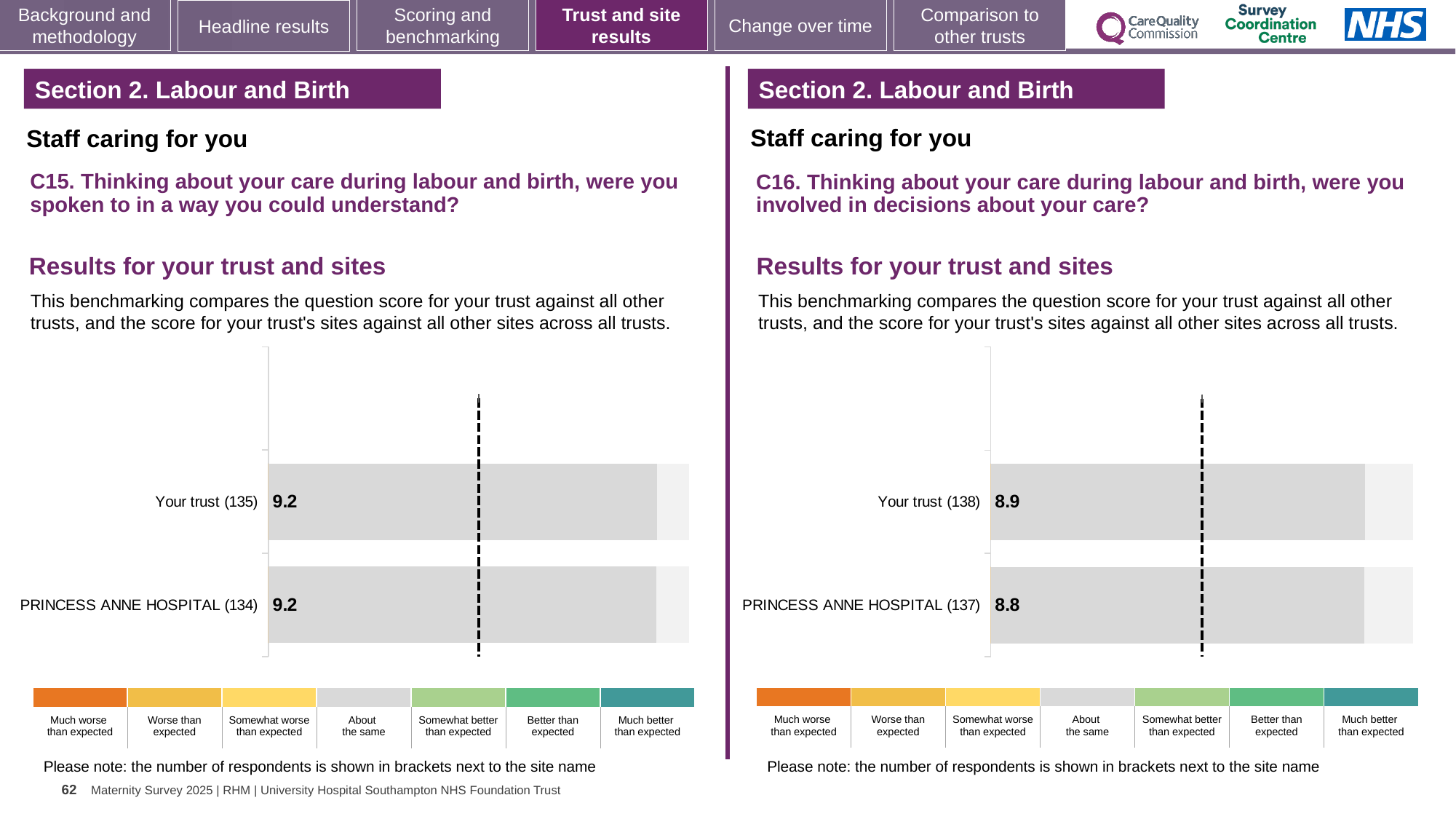
What type of chart is used in the C16 chart on the right? Bar chart How many bars are plotted in the C15 chart on the left? 2 In the C16 chart on the right, how many respondents are shown in brackets for PRINCESS ANNE HOSPITAL? 137 In the C15 chart on the left, how many respondents are shown in brackets for Your trust? 135 In the C16 chart on the right, which category has the lowest score? PRINCESS ANNE HOSPITAL In the C16 chart on the right, what is the score for Your trust? 8.9 In the C15 chart on the left, what is the score for Your trust? 9.2 In the C16 chart on the right, which has the higher score, Your trust or PRINCESS ANNE HOSPITAL? Your trust In the C15 chart on the left, what is the score for PRINCESS ANNE HOSPITAL? 9.2 In the C16 chart on the right, what is the difference between the score for Your trust and the score for PRINCESS ANNE HOSPITAL? 0.1 In the C16 chart on the right, what is the score for PRINCESS ANNE HOSPITAL? 8.8